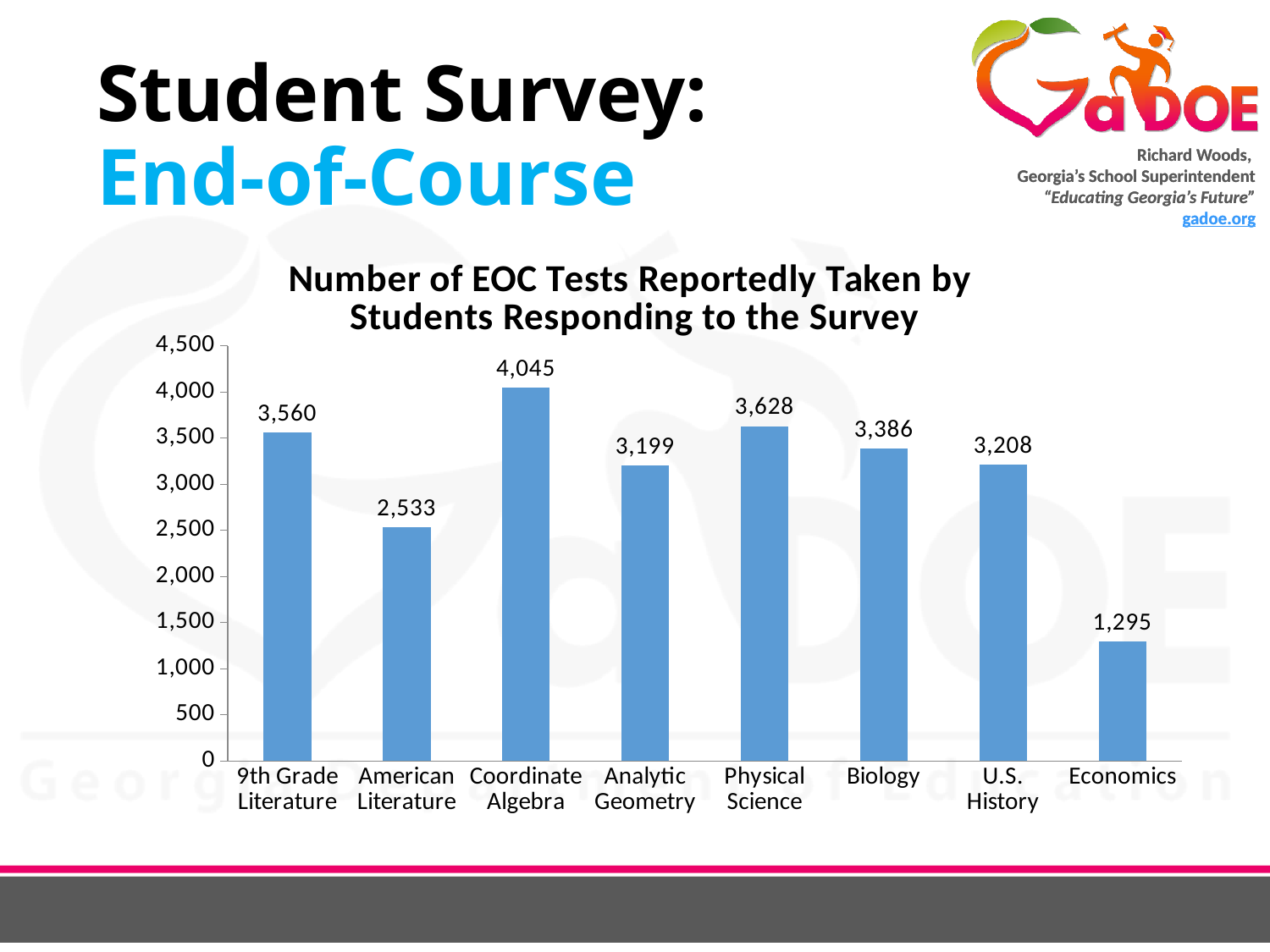
What is the value shown for Economics? 1,295 Is the value for Biology greater or less than 3,000? greater Which course has the highest number of EOC tests reportedly taken? Coordinate Algebra What is the title of the chart? Number of EOC Tests Reportedly Taken by Students Responding to the Survey How many courses are shown on the x axis of the chart? 8 What is the difference between the values for Physical Science and Biology? 242 What is the difference between the values for 9th Grade Literature and American Literature? 1,027 What kind of chart is shown on the slide? bar chart How many EOC tests were reportedly taken in Coordinate Algebra? 4,045 Which course has the lowest number of EOC tests reportedly taken? Economics Which is larger, the value for Analytic Geometry or the value for U.S. History? U.S. History What is the value shown for American Literature? 2,533